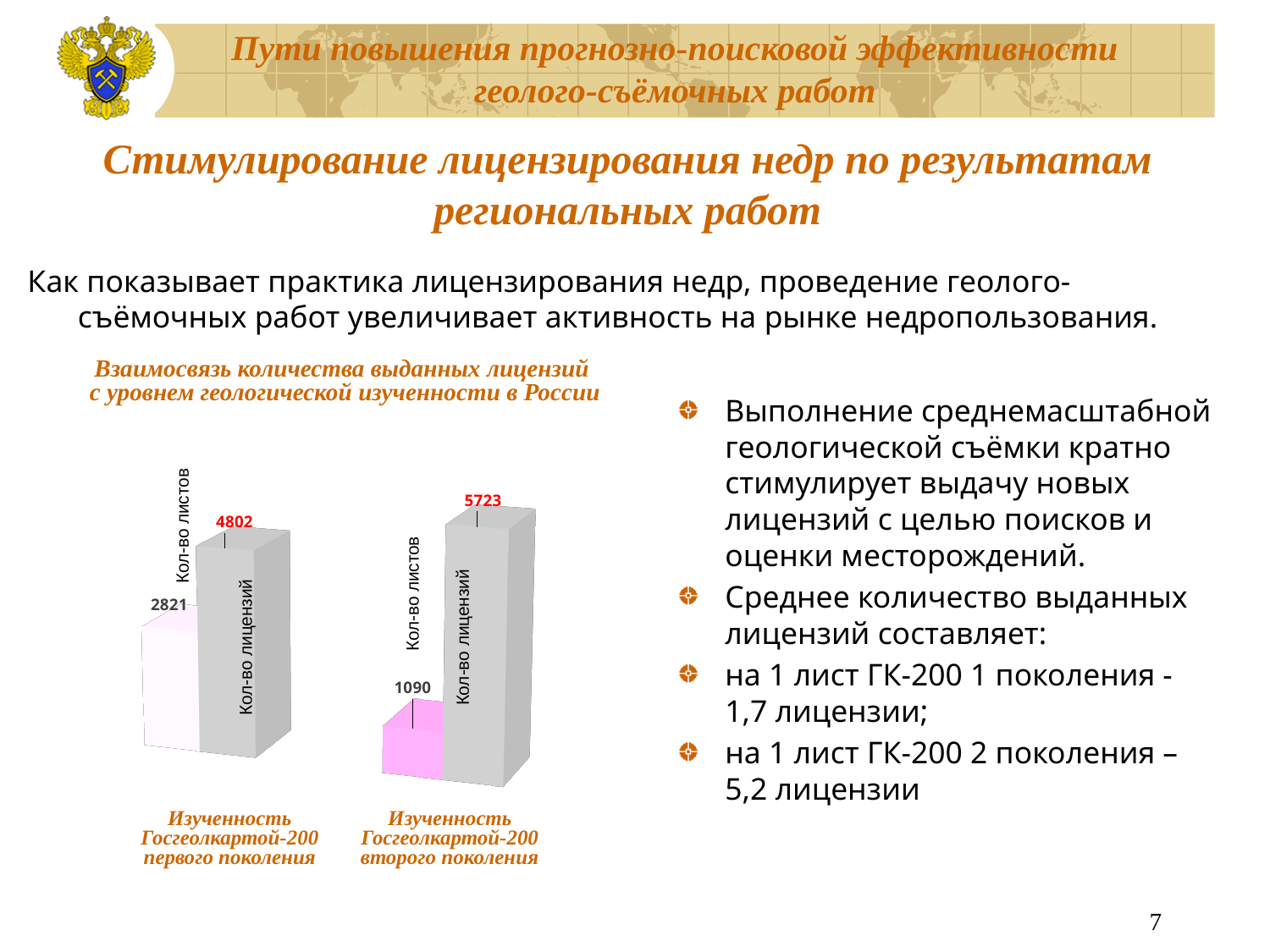
What is the title of the chart? Взаимосвязь количества выданных лицензий с уровнем геологической изученности в России What is the difference between the number of licences and the number of sheets for Изученность Госгеолкартой-200 второго поколения? 4633 Which bar has the highest value in the chart? Кол-во лицензий for Изученность Госгеолкартой-200 второго поколения Which bar has the lowest value in the chart? Кол-во листов for Изученность Госгеолкартой-200 второго поколения What is the number of sheets (Кол-во листов) for Изученность Госгеолкартой-200 первого поколения? 2821 What is the number of sheets (Кол-во листов) for Изученность Госгеолкартой-200 второго поколения? 1090 What is the difference between the number of licences and the number of sheets for Изученность Госгеолкартой-200 первого поколения? 1981 What is the number of licences (Кол-во лицензий) for Изученность Госгеолкартой-200 первого поколения? 4802 Which is larger: the number of licences for the first generation (первого поколения) or for the second generation (второго поколения)? второго поколения How many category groups are shown in the chart? 2 What type of chart is shown on the slide? bar chart What is the number of licences (Кол-во лицензий) for Изученность Госгеолкартой-200 второго поколения? 5723